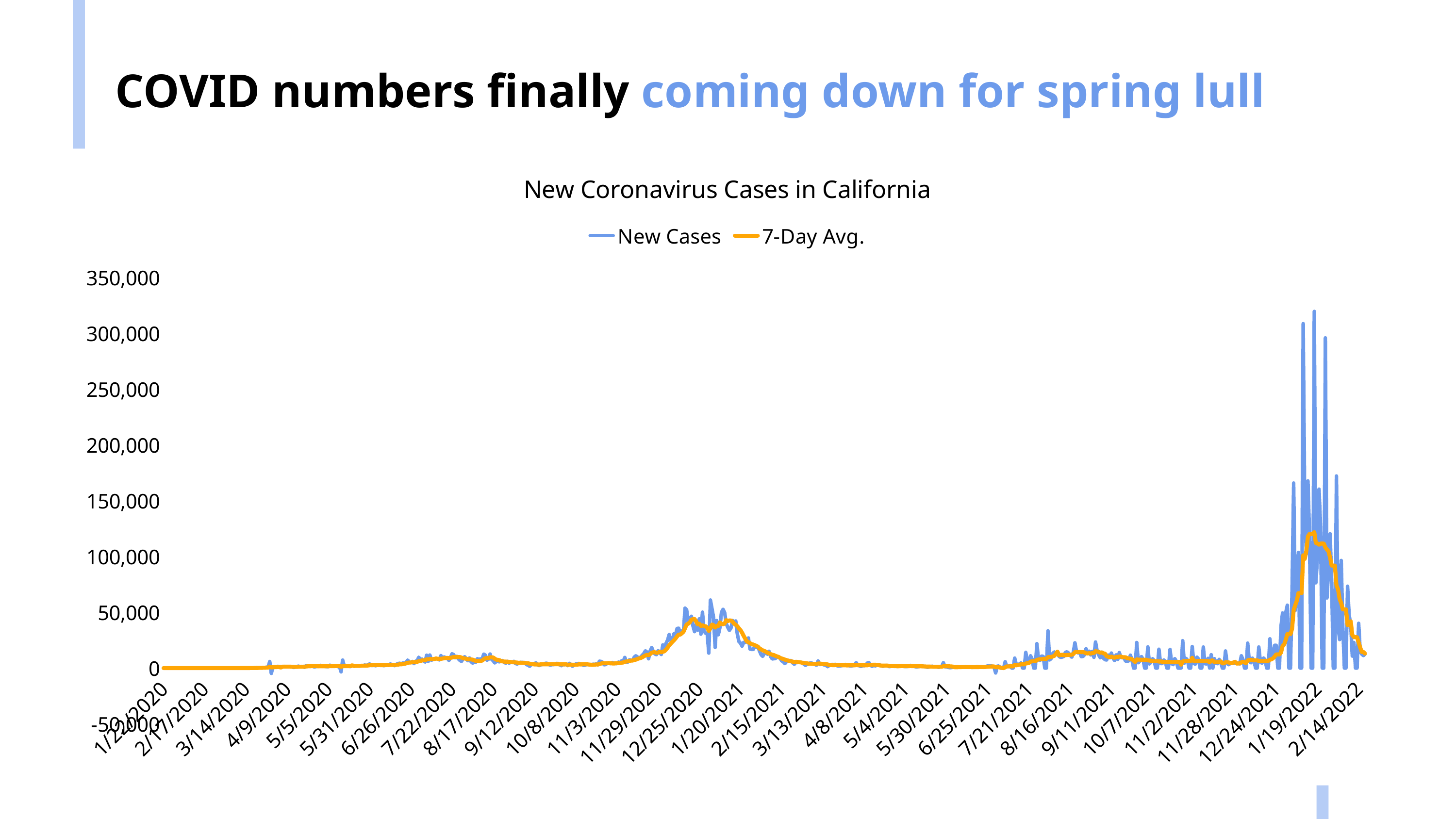
Is the highest point of the 7-Day Avg. series greater or less than 150,000? less How many series does the chart's legend list? 2 Which is larger: the peak of the 7-Day Avg. series near 1/19/2022 or its peak near 12/25/2020? The peak near 1/19/2022 Which series is drawn in orange? 7-Day Avg. Is the highest peak of the New Cases series greater or less than 300,000? greater What is the title of the chart? New Coronavirus Cases in California What is the highest value shown on the vertical axis? 350,000 Do the 7-Day Avg. values rise or fall between 1/19/2022 and 2/14/2022? fall Is the 7-Day Avg. value around 12/25/2020 greater or less than 100,000? less What kind of chart is shown on the slide? Line chart